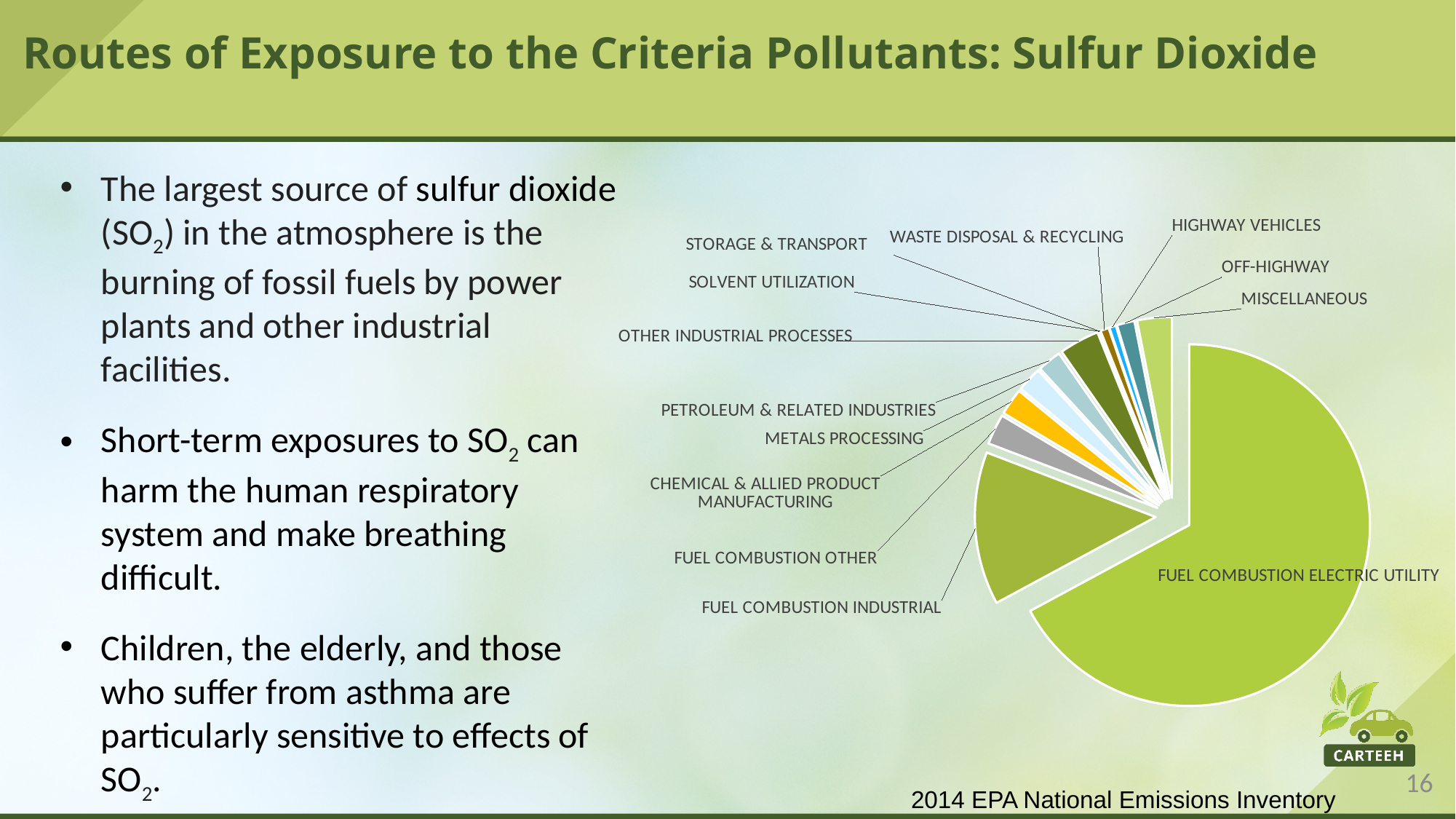
Which is larger in the pie chart, Fuel Combustion Electric Utility or Fuel Combustion Industrial? Fuel Combustion Electric Utility What colour is the Fuel Combustion Electric Utility slice in the pie chart? light green What kind of chart is shown on the slide? pie chart What data source is cited below the pie chart? 2014 EPA National Emissions Inventory Which is larger in the pie chart, Fuel Combustion Electric Utility or Chemical & Allied Product Manufacturing? Fuel Combustion Electric Utility Which is larger in the pie chart, Fuel Combustion Industrial or Metals Processing? Fuel Combustion Industrial How many categories are shown in the pie chart? 13 Which category has the second-largest slice in the pie chart? Fuel Combustion Industrial Which category has the largest slice in the pie chart? Fuel Combustion Electric Utility